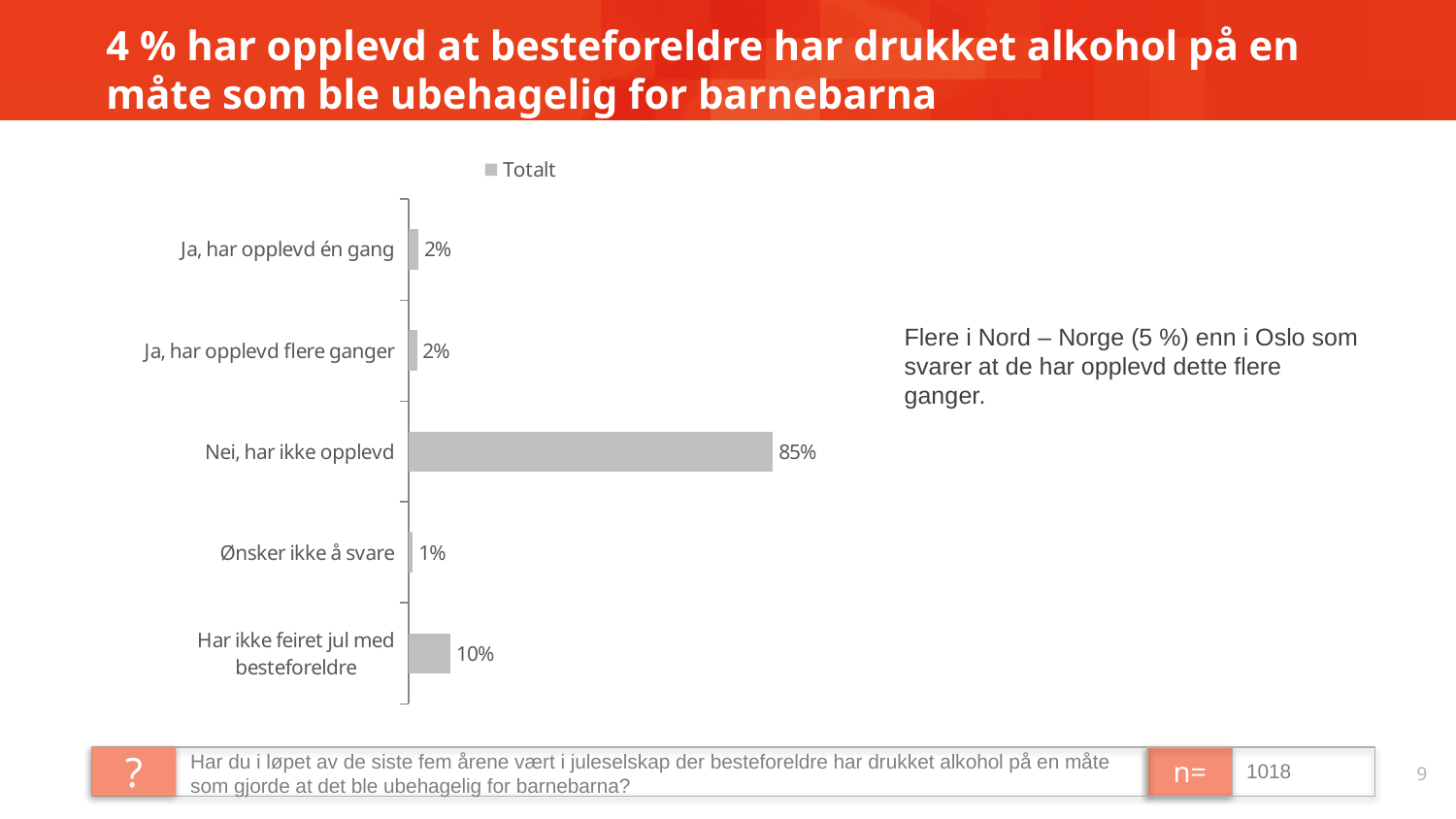
What is the name of the series in the legend? Totalt What is the difference between "Nei, har ikke opplevd" and "Har ikke feiret jul med besteforeldre"? 75 percentage points What kind of chart is shown on the slide? Bar chart What is the value for "Ja, har opplevd én gang"? 2% What is the value for "Nei, har ikke opplevd"? 85% What is the value for "Har ikke feiret jul med besteforeldre"? 10% Which category has the highest value? Nei, har ikke opplevd What is the value for "Ønsker ikke å svare"? 1% How many series does the legend list? 1 How many categories are shown in the chart? 5 Which category has the lowest value? Ønsker ikke å svare Which is larger: "Har ikke feiret jul med besteforeldre" or "Ja, har opplevd flere ganger"? Har ikke feiret jul med besteforeldre